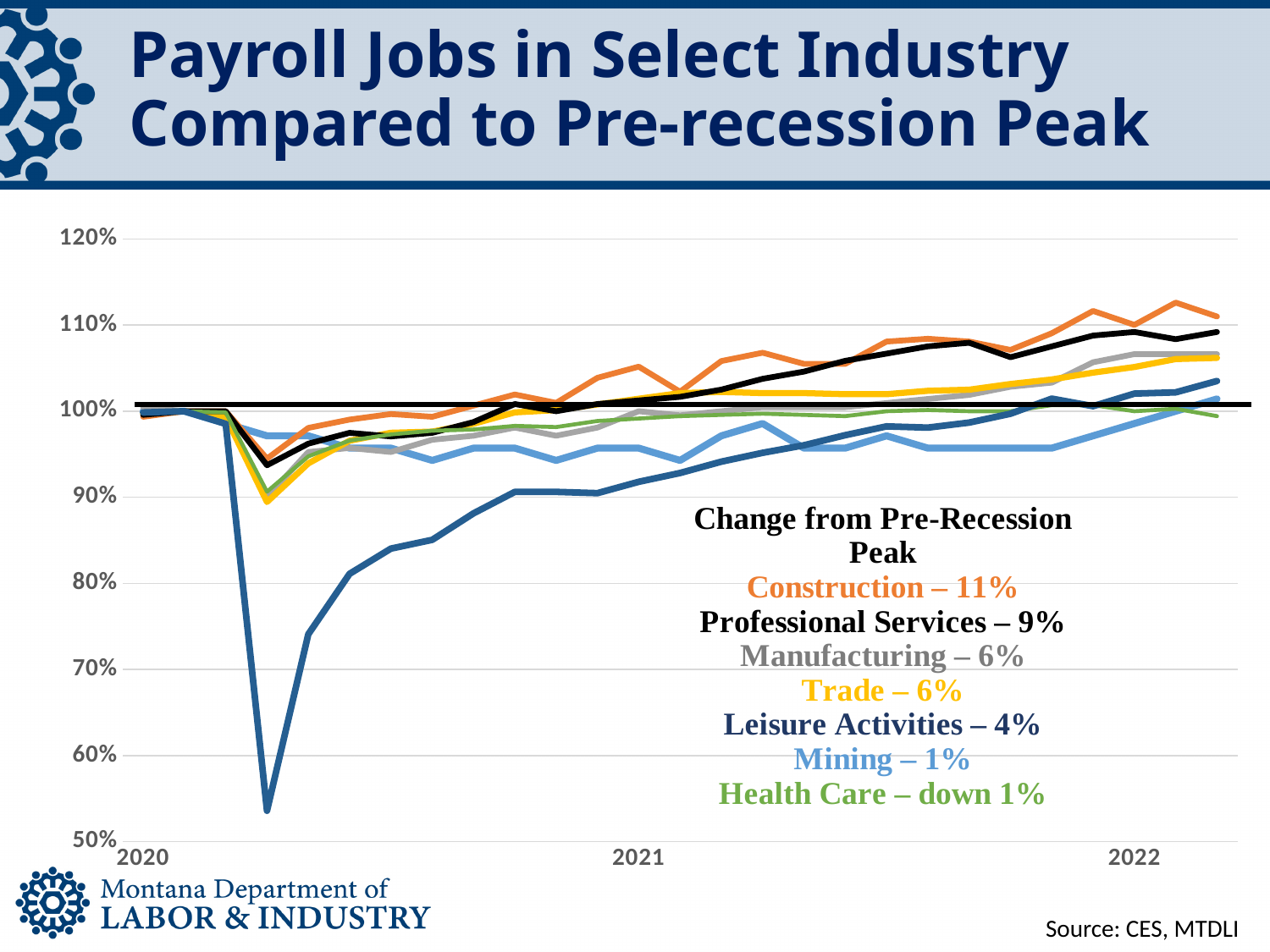
Which has a larger change from pre-recession peak, Leisure Activities or Mining? Leisure Activities Which industry has the largest change from pre-recession peak? Construction What colour is the Construction line? Orange How many percentage points higher is Construction's change from pre-recession peak than Professional Services'? 2 percentage points Which industry has the lowest change from pre-recession peak? Health Care According to the text box, what is the change from pre-recession peak for Construction? 11% How many industries are listed in the text box on the chart? 7 According to the text box, what is the change from pre-recession peak for Professional Services? 9% What type of chart is shown on the slide? Line chart Is the lowest point of the Leisure Activities line in 2020 greater or less than 60%? less According to the text box, what is the change from pre-recession peak for Health Care? down 1% Does the Leisure Activities line rise or fall from its 2020 low point to 2022? Rises